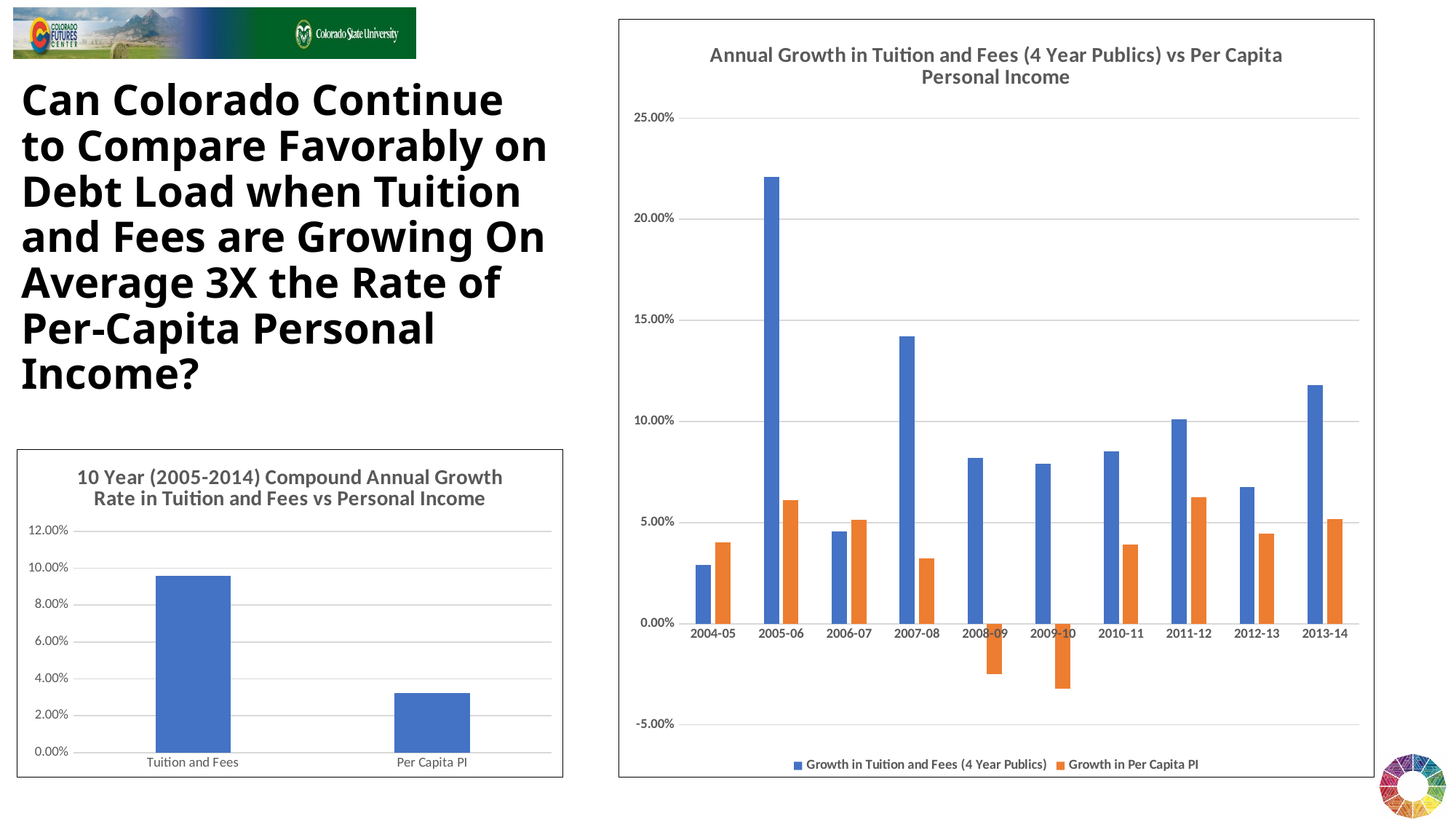
In the right chart, which year has the lowest Growth in Per Capita PI? 2009-10 How many years are shown on the x axis of the right chart? 10 How many series does the legend of the right chart list? 2 In the right chart, which is larger for 2004-05, Growth in Tuition and Fees (4 Year Publics) or Growth in Per Capita PI? Growth in Per Capita PI In the right chart, is the Growth in Tuition and Fees (4 Year Publics) for 2005-06 greater or less than 20.00%? greater In the right chart, which year has the highest Growth in Tuition and Fees (4 Year Publics)? 2005-06 In the left chart, is the value for Per Capita PI greater or less than 4.00%? less In the right chart, which year has the lowest Growth in Tuition and Fees (4 Year Publics)? 2004-05 What kind of chart is the left chart? Bar chart In the left chart, which category has the higher value, Tuition and Fees or Per Capita PI? Tuition and Fees In the left chart, is the value for Tuition and Fees greater or less than 8.00%? greater How many categories are shown in the left chart? 2